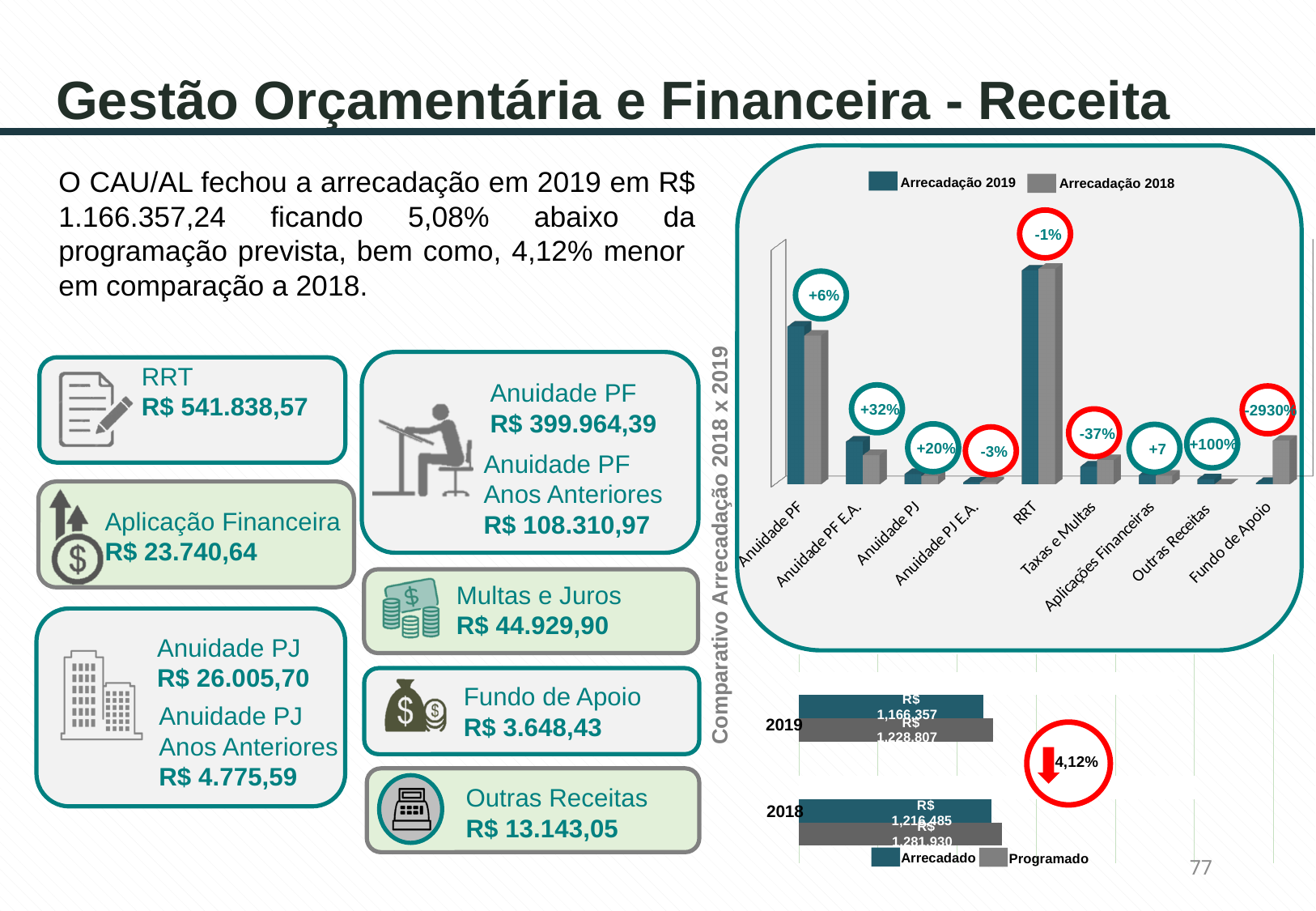
In the bottom chart (Arrecadado vs Programado), what is the difference between Programado and Arrecadado for 2019? R$ 62.450 In the bottom chart (Arrecadado vs Programado), which is larger for 2019, Arrecadado or Programado? Programado In the top chart 'Comparativo Arrecadação 2018 x 2019', how many categories are shown on the x axis? 9 What type of chart is the top chart titled 'Comparativo Arrecadação 2018 x 2019'? bar chart In the top chart 'Comparativo Arrecadação 2018 x 2019', what percentage change is labelled above Anuidade PF? +6% In the top chart 'Comparativo Arrecadação 2018 x 2019', what percentage change is labelled above Fundo de Apoio? -2930% In the top chart 'Comparativo Arrecadação 2018 x 2019', which category has the highest bars? RRT In the top chart 'Comparativo Arrecadação 2018 x 2019', how many series does the legend list? 2 In the bottom chart (Arrecadado vs Programado), what is the Programado value for 2018? R$ 1.281.930 In the top chart 'Comparativo Arrecadação 2018 x 2019', what are the two legend entries? Arrecadação 2019 and Arrecadação 2018 In the top chart 'Comparativo Arrecadação 2018 x 2019', what percentage change is labelled above Taxas e Multas? -37% In the bottom chart (Arrecadado vs Programado), what is the Arrecadado value for 2019? R$ 1.166.357